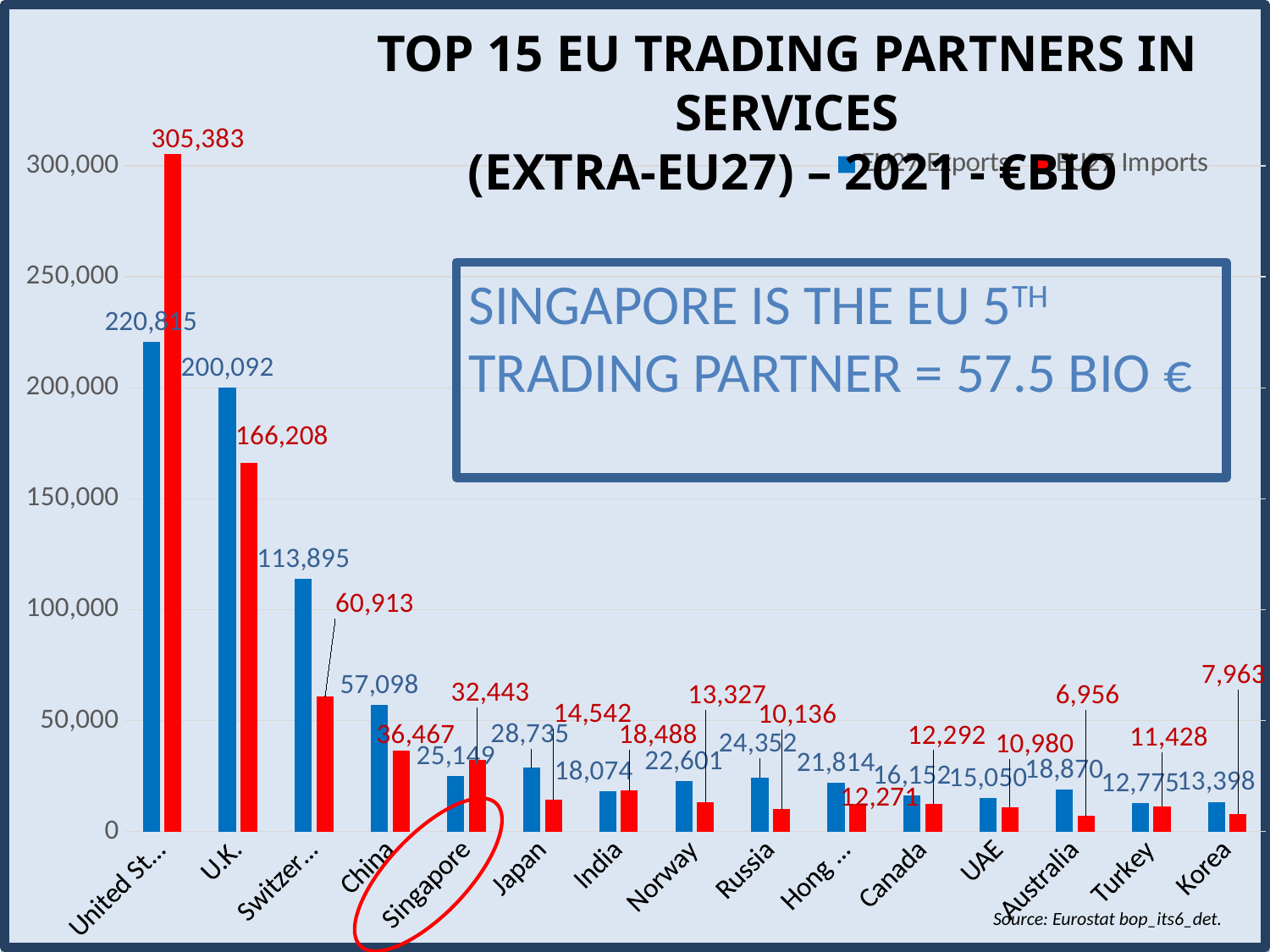
For Singapore, which is larger: EU27 Exports or EU27 Imports? EU27 Imports Which trading partner has the highest EU27 Imports value? United States How many trading partners are shown on the x axis? 15 What is the difference between EU27 Exports and EU27 Imports for the U.K.? 33,884 What is the EU27 Exports value for the U.K.? 200,092 What is the difference between EU27 Exports and EU27 Imports for Japan? 14,193 Which trading partner has the lowest EU27 Imports value? Australia What is the EU27 Exports value for China? 57,098 Is the EU27 Exports value for Switzerland greater or less than 100,000? greater How many series does the legend list? 2 What is the EU27 Imports value for Singapore? 32,443 What kind of chart is shown on the slide? Bar chart